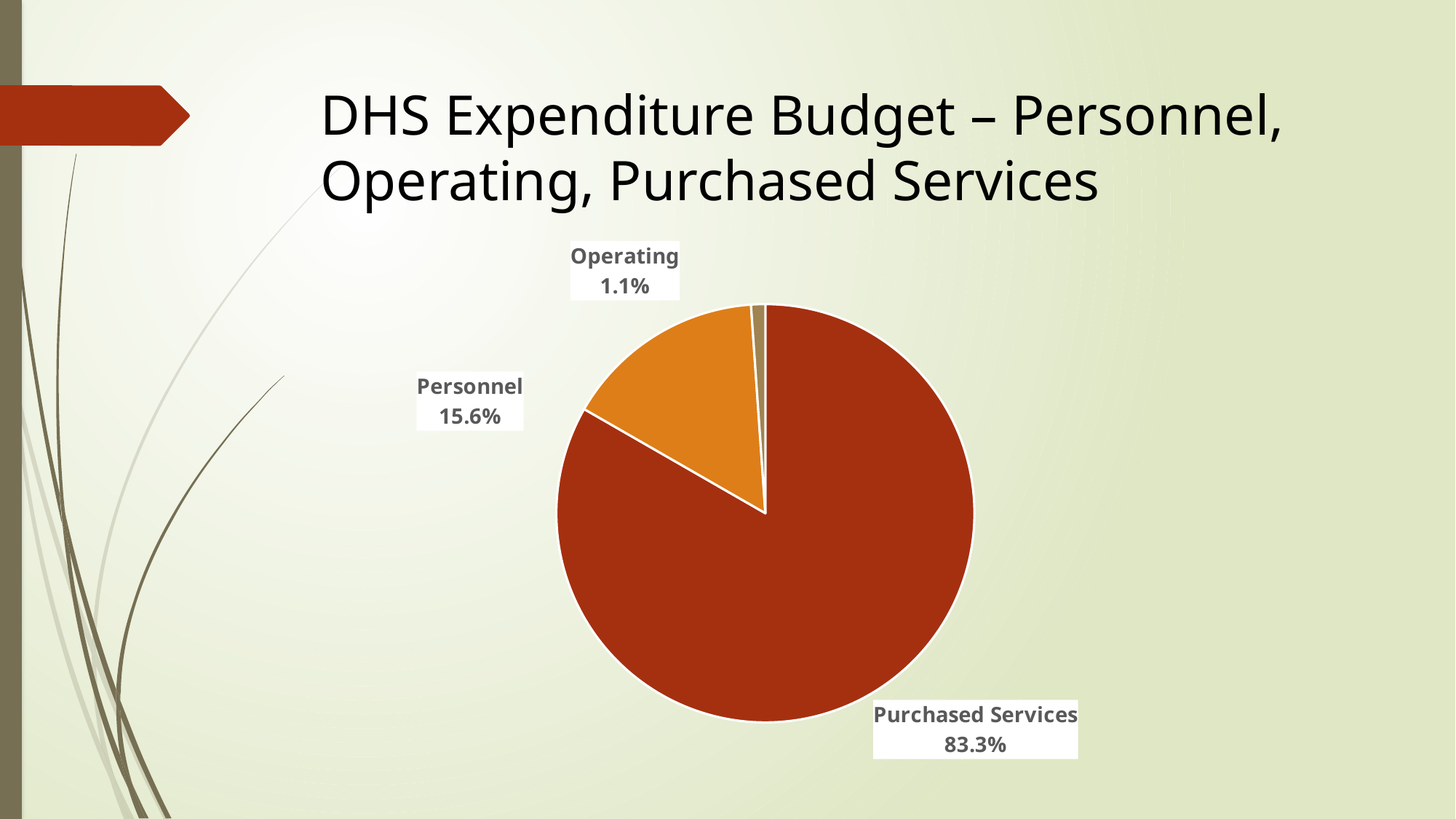
What share of the DHS expenditure budget is Operating? 1.1% What colour is the Purchased Services slice? dark red Which is larger, the Personnel slice or the Operating slice? Personnel What share of the DHS expenditure budget is Purchased Services? 83.3% What share of the DHS expenditure budget is Personnel? 15.6% What kind of chart is shown on the slide? pie chart Which category has the largest slice of the pie? Purchased Services What is the difference in percentage points between Personnel and Operating? 14.5 Which category has the smallest slice of the pie? Operating How many categories are shown in the pie chart? 3 What is the title of the slide containing the pie chart? DHS Expenditure Budget – Personnel, Operating, Purchased Services What is the difference in percentage points between Purchased Services and Personnel? 67.7